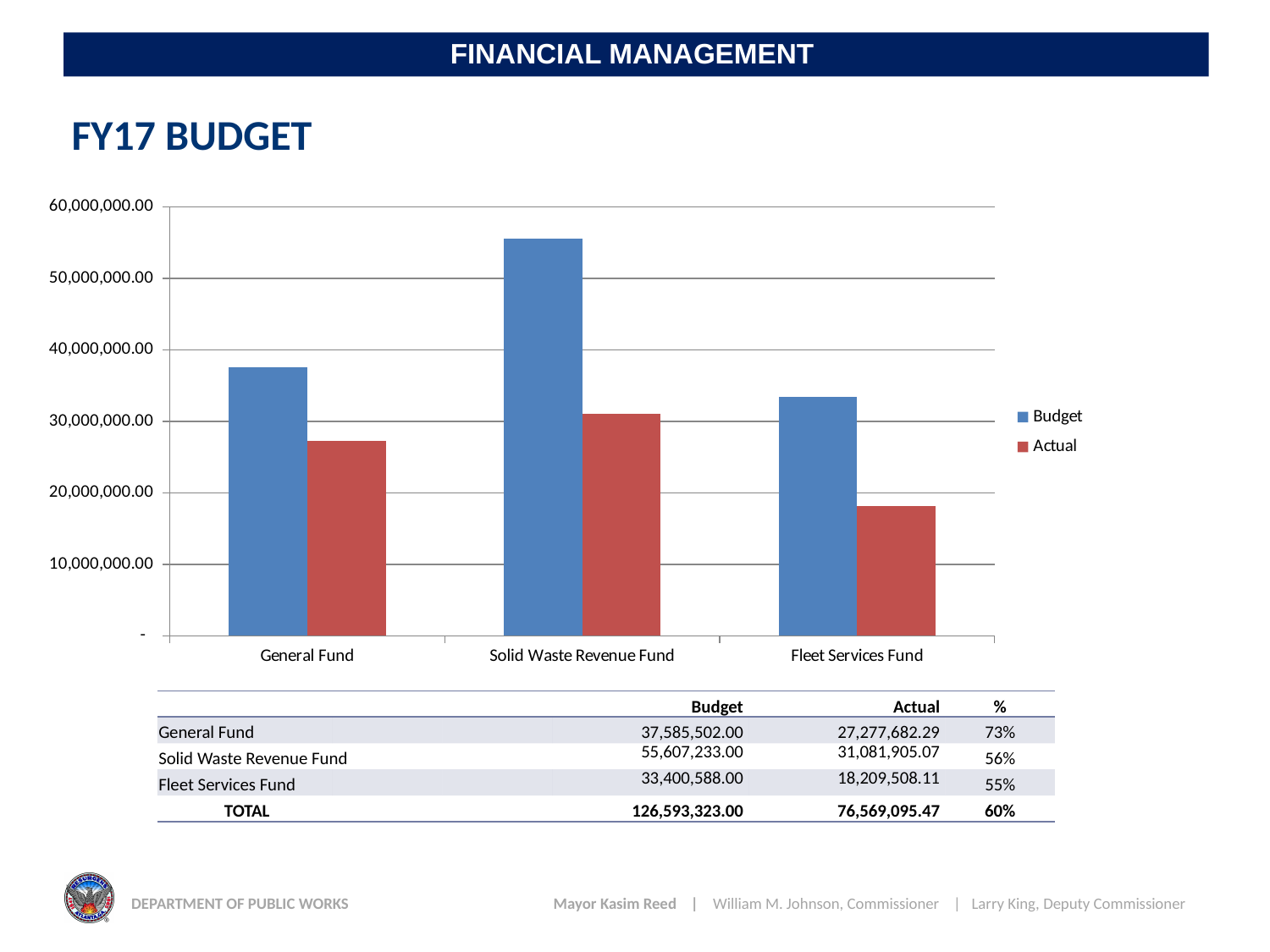
What is the Actual value for the Fleet Services Fund? 18,209,508.11 How many series does the chart legend list? 2 Which is larger for the Solid Waste Revenue Fund, the Budget or the Actual value? Budget Which fund has the lowest Actual value? Fleet Services Fund Which fund has the highest Budget value? Solid Waste Revenue Fund How many fund categories are shown on the x axis of the chart? 3 What is the Budget value for the General Fund? 37,585,502.00 What is the Actual value for the Solid Waste Revenue Fund? 31,081,905.07 Is the Actual value for the General Fund greater or less than 30,000,000.00? less What kind of chart is shown on the FY17 Budget slide? bar chart Is the Budget value for the Fleet Services Fund greater or less than 30,000,000.00? greater Which colour represents the Actual series in the chart? red